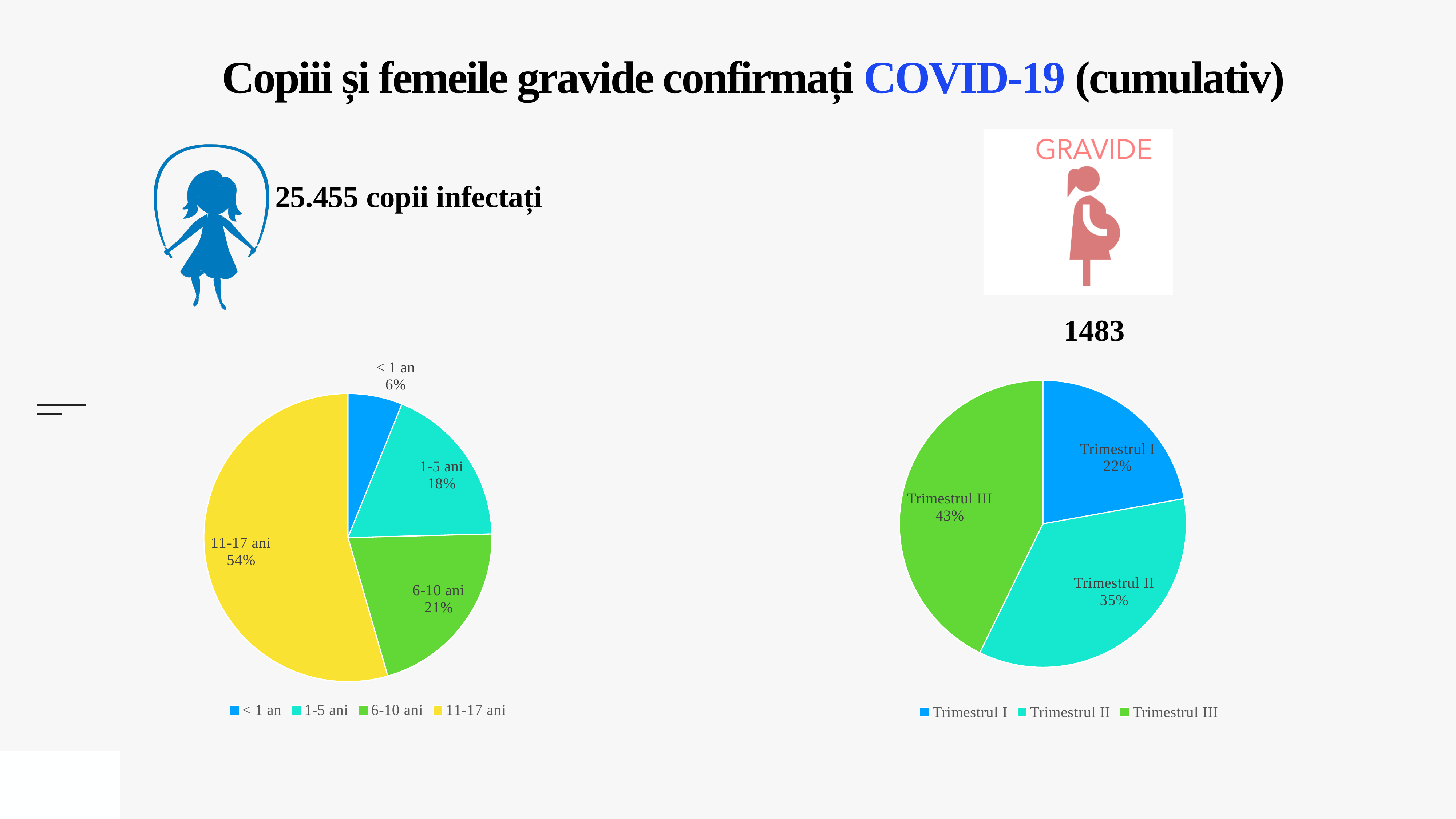
In the left pie chart (children by age group), which age group has the largest slice? 11-17 ani In the right pie chart (pregnant women by trimester), what is the difference in percentage points between Trimestrul III and Trimestrul I? 21 In the right pie chart (pregnant women by trimester), which trimester has the smallest slice? Trimestrul I In the left pie chart (children by age group), which age group has the smallest slice? < 1 an In the right pie chart (pregnant women by trimester), what share is labelled for Trimestrul II? 35% In the left pie chart (children by age group), how many categories does the legend list? 4 In the left pie chart (children by age group), what is the difference in percentage points between 6-10 ani and 1-5 ani? 3 In the right pie chart (pregnant women by trimester), which trimester has the largest slice? Trimestrul III What kind of chart is the right chart (pregnant women by trimester)? Pie chart In the left pie chart (children by age group), what share is labelled for < 1 an? 6% In the right pie chart (pregnant women by trimester), what colour is the Trimestrul III slice? Green In the left pie chart (children by age group), what share is labelled for 11-17 ani? 54%